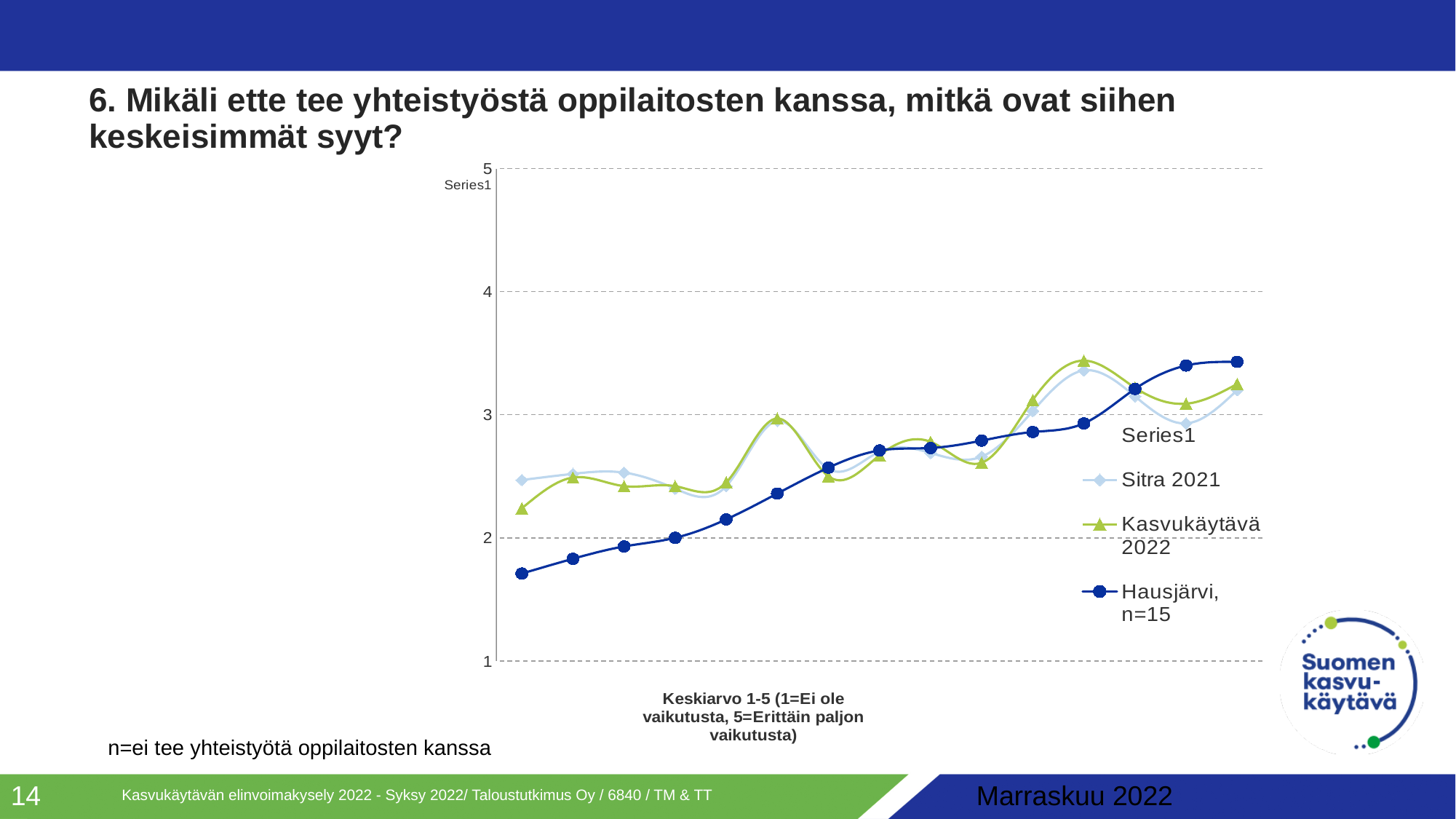
What is the range of the chart's vertical axis? 1 to 5 How many data points does the Hausjärvi, n=15 line have? 15 Is the first (leftmost) value of the Hausjärvi, n=15 line greater or less than 2? less Which series are listed in the chart legend? Series1, Sitra 2021, Kasvukäytävä 2022, Hausjärvi, n=15 Is the first (leftmost) value of the Sitra 2021 line greater or less than 2? greater What kind of chart is shown on the slide? line chart Which series contains the lowest value plotted on the chart? Hausjärvi, n=15 Do the values of the Hausjärvi, n=15 line rise or fall from left to right along the x axis? rise At the rightmost point, which line is higher: Hausjärvi, n=15 or Kasvukäytävä 2022? Hausjärvi, n=15 How many series does the chart legend list? 4 Is the last (rightmost) value of the Hausjärvi, n=15 line greater or less than 3? greater At the leftmost point, which line is higher: Sitra 2021 or Hausjärvi, n=15? Sitra 2021